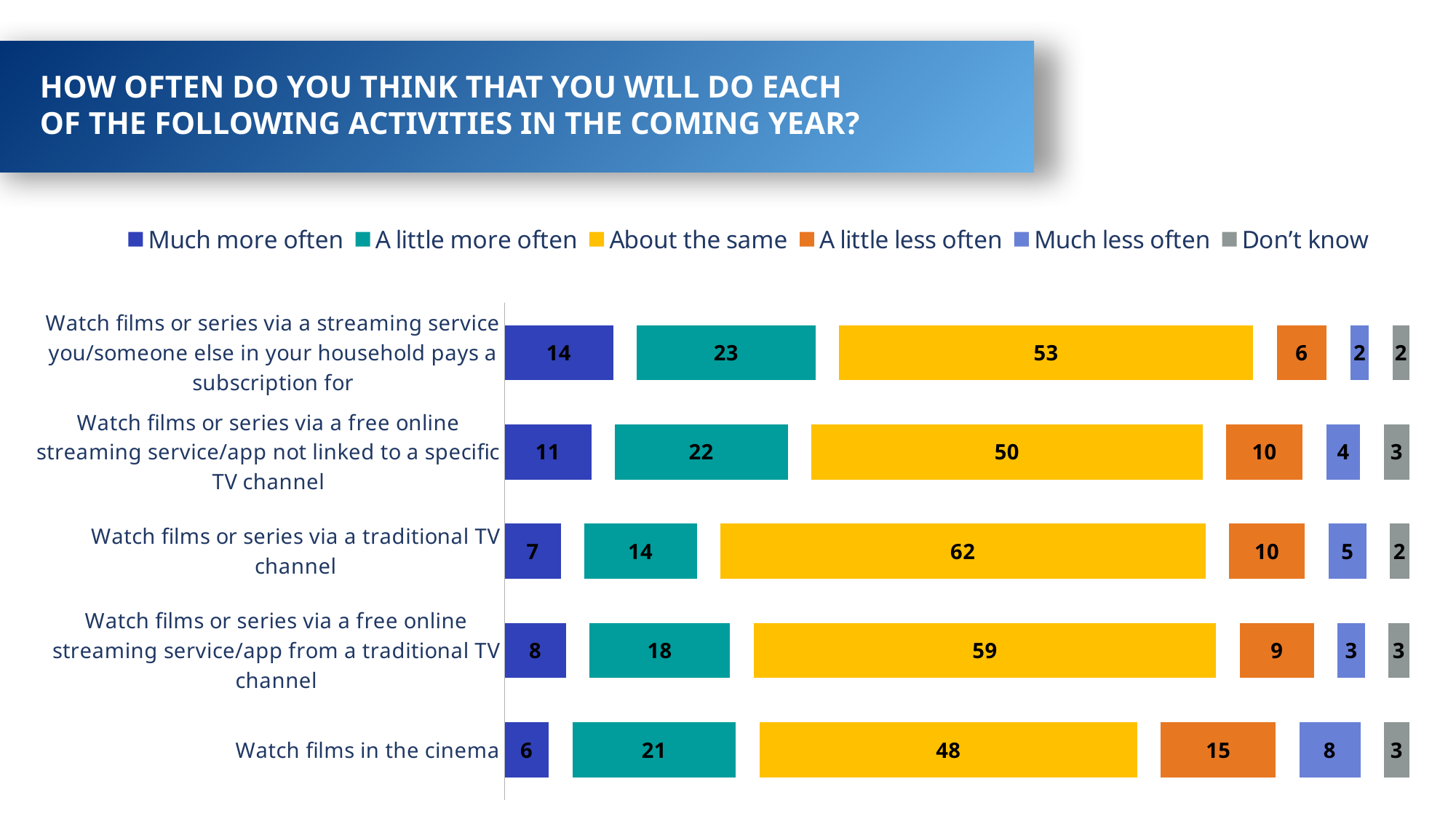
What kind of chart is shown on the slide? Stacked bar chart How many series does the legend list? 6 What is the value for "About the same" for "Watch films or series via a traditional TV channel"? 62 Which activity has the highest value for "Much more often"? Watch films or series via a streaming service you/someone else in your household pays a subscription for Which legend entry is shown in orange? A little less often What is the difference between the "About the same" values for "Watch films or series via a traditional TV channel" and "Watch films in the cinema"? 14 How many activities are shown in the chart? 5 What is the value for "Much more often" for "Watch films in the cinema"? 6 What is the value for "A little less often" for "Watch films or series via a free online streaming service/app not linked to a specific TV channel"? 10 What is the total of the stacked bar for "Watch films in the cinema"? 101 Which is larger: the "A little more often" value for "Watch films in the cinema" or for "Watch films or series via a traditional TV channel"? Watch films in the cinema Which activity has the lowest value for "About the same"? Watch films in the cinema